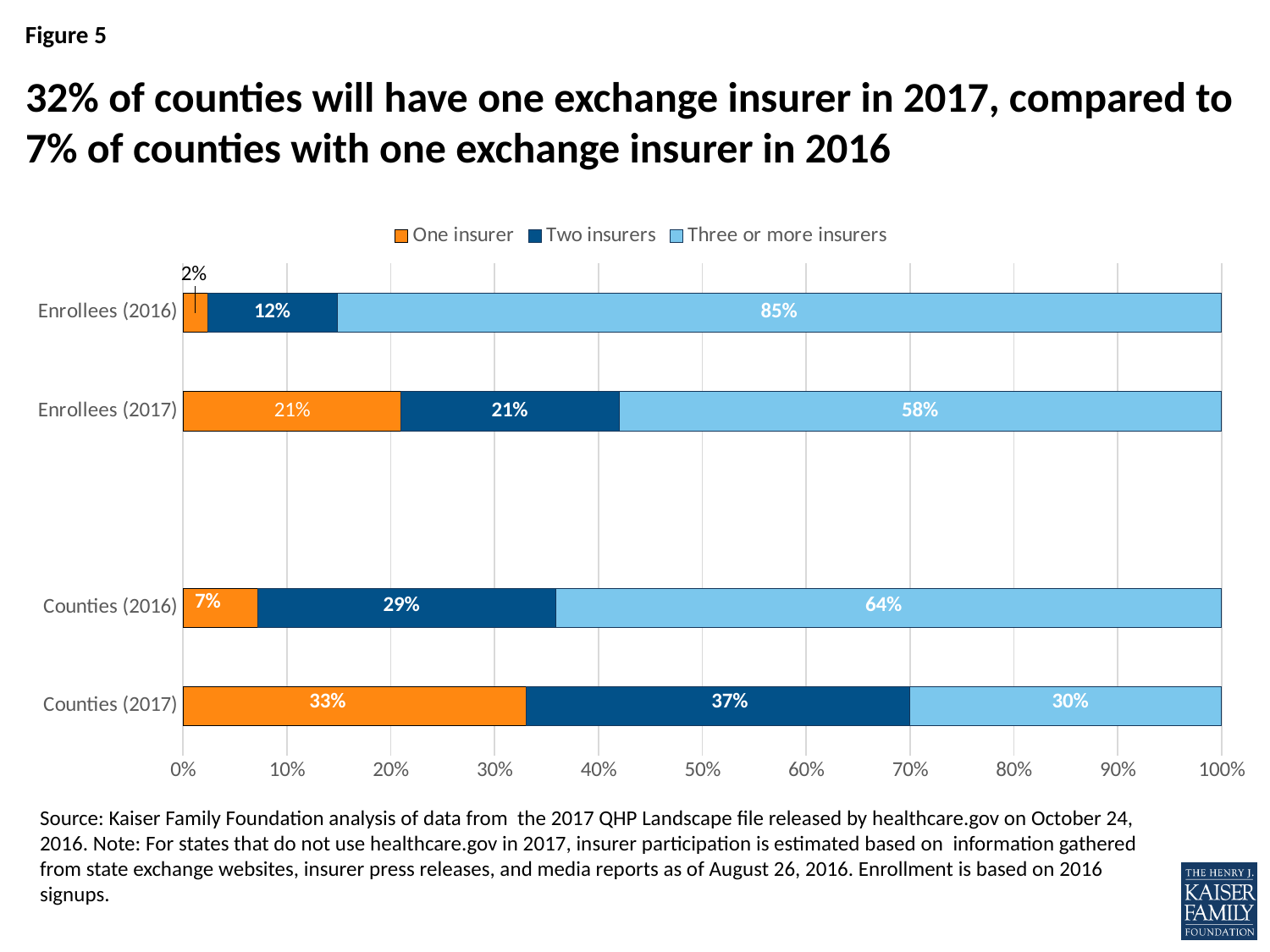
What is the difference between the one-insurer share for Counties (2017) and Counties (2016)? 26 percentage points What share of Counties (2017) have one insurer? 33% What share of Enrollees (2017) have one insurer? 21% What share of Counties (2016) have two insurers? 29% What share of Enrollees (2016) have three or more insurers? 85% How many series does the legend list? 3 Which category has the highest share with one insurer? Counties (2017) What kind of chart is shown? Stacked bar chart How many categories are shown on the y axis? 4 Which is larger: the three-or-more-insurers share for Enrollees (2017) or for Counties (2016)? Counties (2016) Which colour represents the 'One insurer' series? Orange Which category has the lowest share with three or more insurers? Counties (2017)